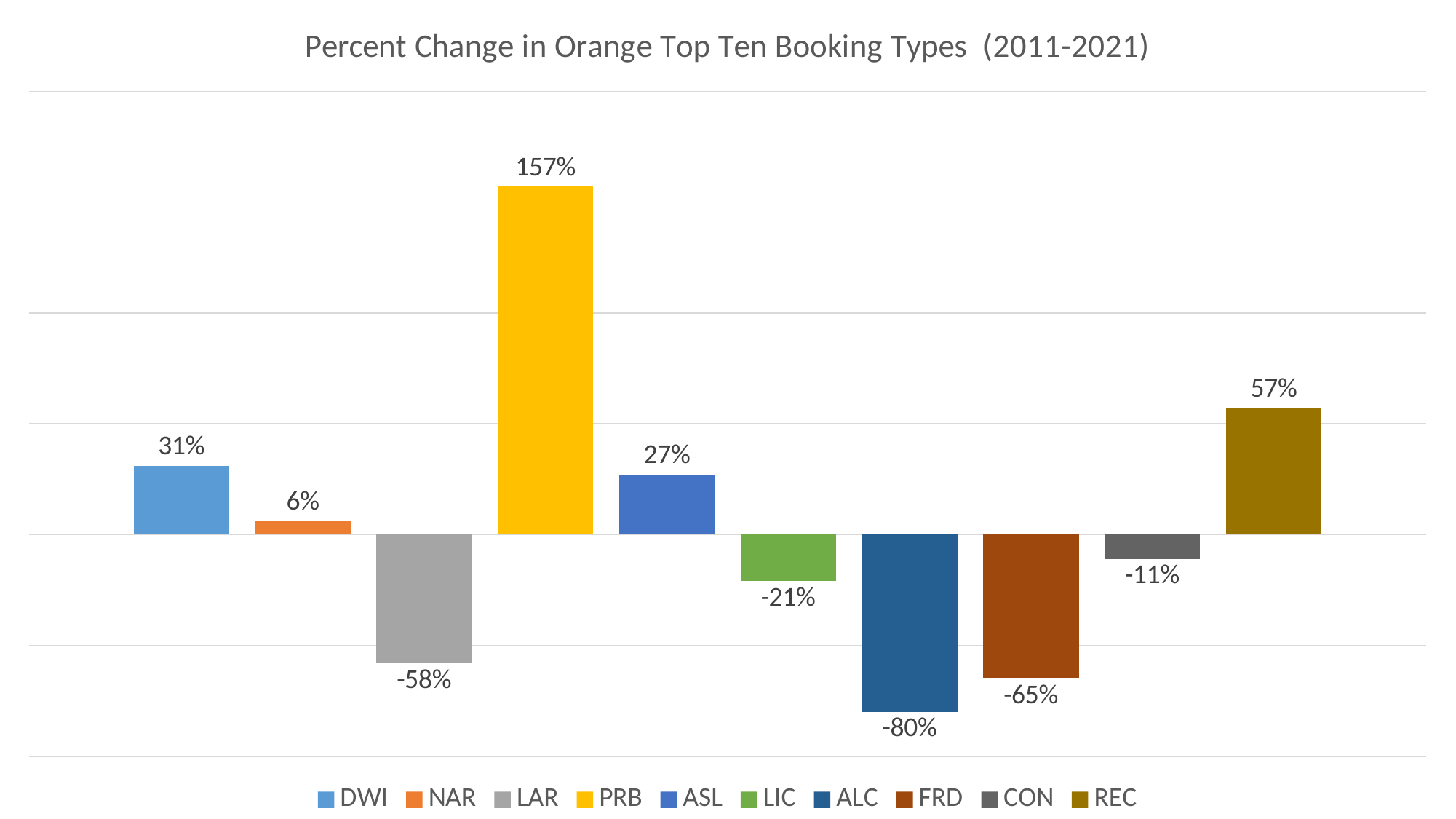
Which has a larger percent change, DWI or ASL? DWI Which has a larger percent change, LAR or FRD? LAR Which booking type has the lowest percent change? ALC How many entries does the legend list? 10 What is the difference between the percent change for REC and the percent change for DWI? 26% What is the percent change for CON? -11% What is the percent change for ALC? -80% What is the title of the chart? Percent Change in Orange Top Ten Booking Types (2011-2021) How many booking types are shown in the chart? 10 Which booking type has the highest percent change? PRB What type of chart is shown? Bar chart What is the percent change for PRB? 157%